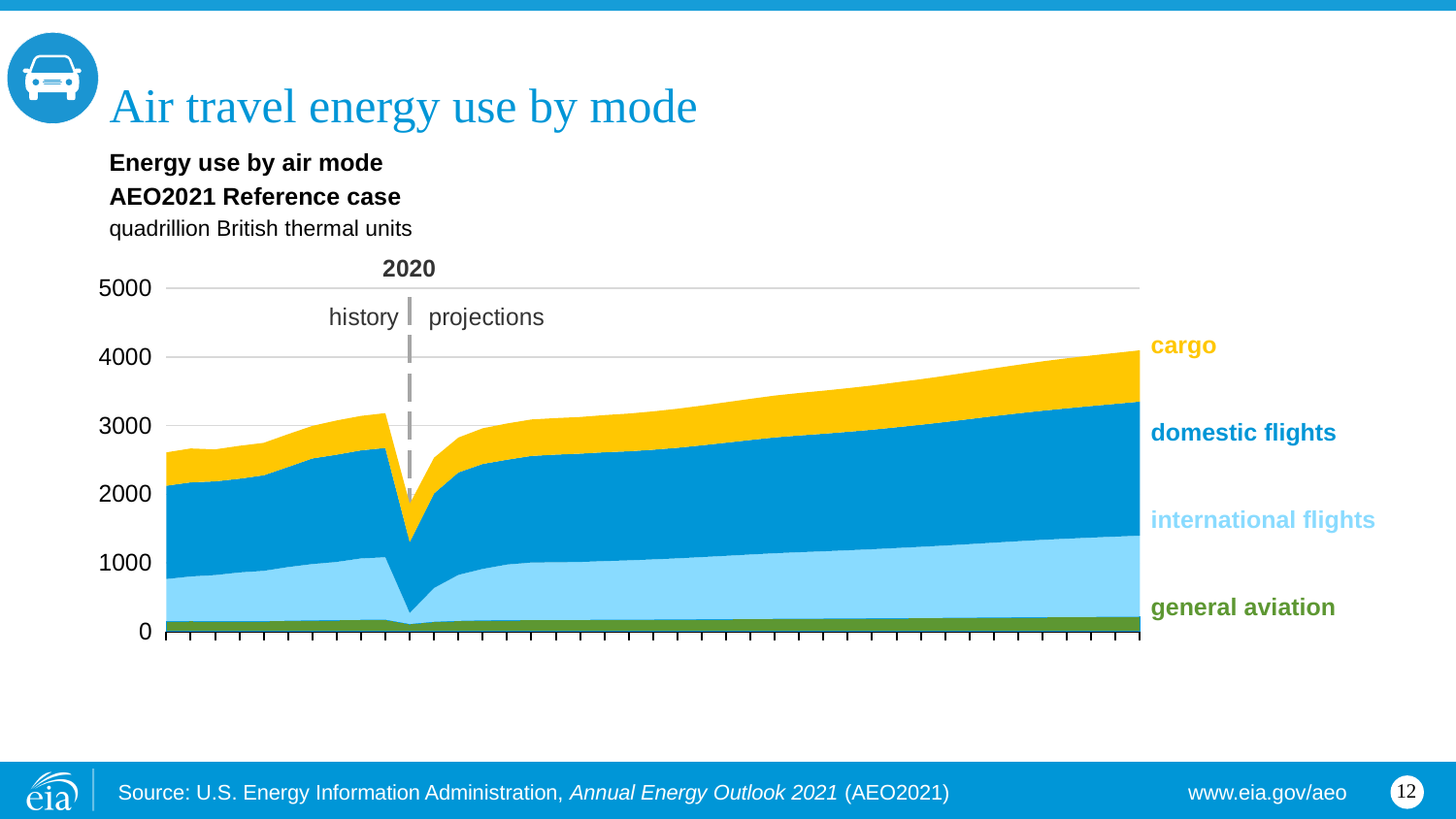
What is the title of the chart? Energy use by air mode, AEO2021 Reference case Which air mode accounts for the smallest share of energy use in the chart? general aviation What unit is given for the values in the chart? quadrillion British thermal units Does total air travel energy use rise or fall over the projection period after 2020? rise Is the total air travel energy use at the 2020 dip greater or less than 2000? less Which is larger in the chart, energy use for domestic flights or for international flights? domestic flights Which year marks the boundary between history and projections in the chart? 2020 How many series (air modes) are shown in the chart? 4 Is the total air travel energy use at the start of the history period greater or less than 2000? greater What kind of chart is shown on the slide? stacked area chart Is the total air travel energy use at the end of the projection period greater or less than 3000? greater Which air mode accounts for the largest share of energy use in the chart? domestic flights